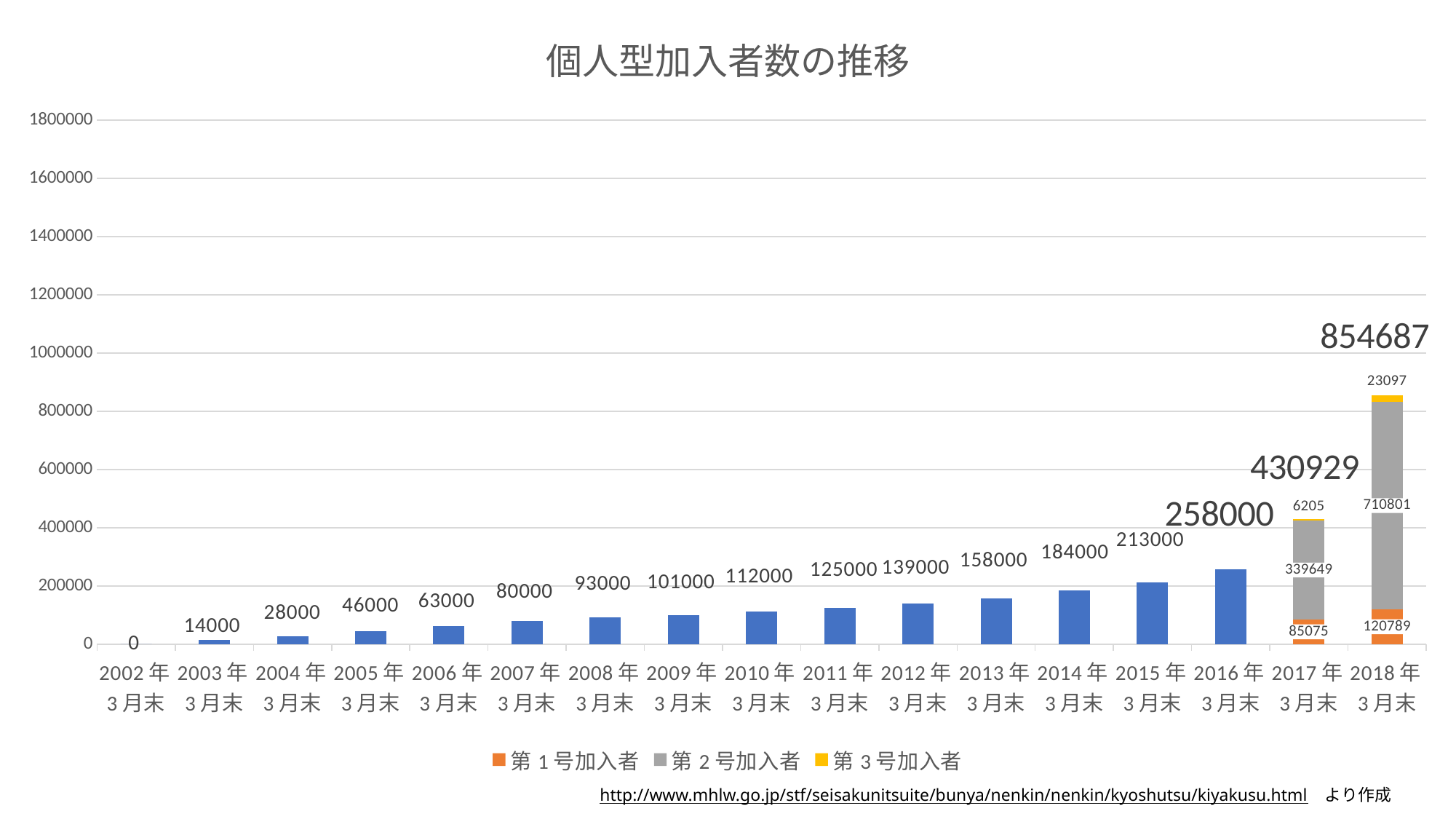
What is the value of 第1号加入者 for 2017年3月末? 85075 What kind of chart is shown on the slide? bar chart What is the total labeled above the stacked bar for 2017年3月末? 430929 Which category has the highest total value? 2018年3月末 What is the title of the chart? 個人型加入者数の推移 What is the value labeled for 2010年3月末? 112000 What is the difference between the values for 2016年3月末 and 2015年3月末? 45000 Which category has the lowest value? 2002年3月末 How many series does the legend list? 3 How many categories are shown on the x axis? 17 Do the values rise or fall from 2002年3月末 to 2018年3月末? rise What is the value of 第2号加入者 for 2018年3月末? 710801